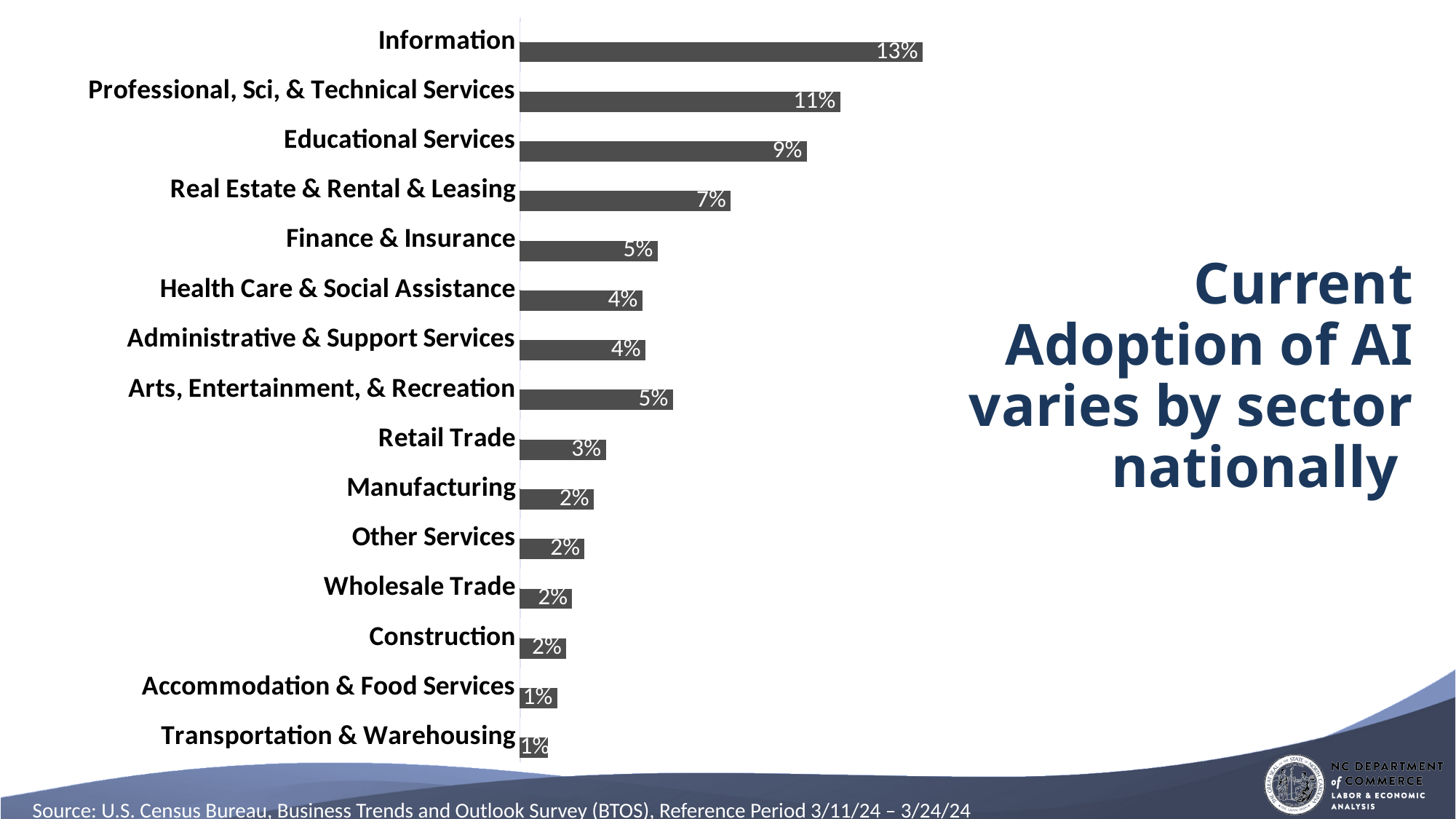
What is the difference between the values for Real Estate & Rental & Leasing and Finance & Insurance? 2% What is the difference between the values for Information and Professional, Sci, & Technical Services? 2% Which sector has the highest AI adoption rate on the chart? Information What is the title text shown next to the chart? Current Adoption of AI varies by sector nationally What is the AI adoption rate shown for Information? 13% What value is shown for Educational Services? 9% Which is larger, the value for Arts, Entertainment, & Recreation or the value for Retail Trade? Arts, Entertainment, & Recreation Which is larger, the value for Educational Services or the value for Real Estate & Rental & Leasing? Educational Services How many sectors are shown on the chart? 15 What kind of chart is shown on the slide? Bar chart What value is shown for Retail Trade? 3% What value is shown for Health Care & Social Assistance? 4%